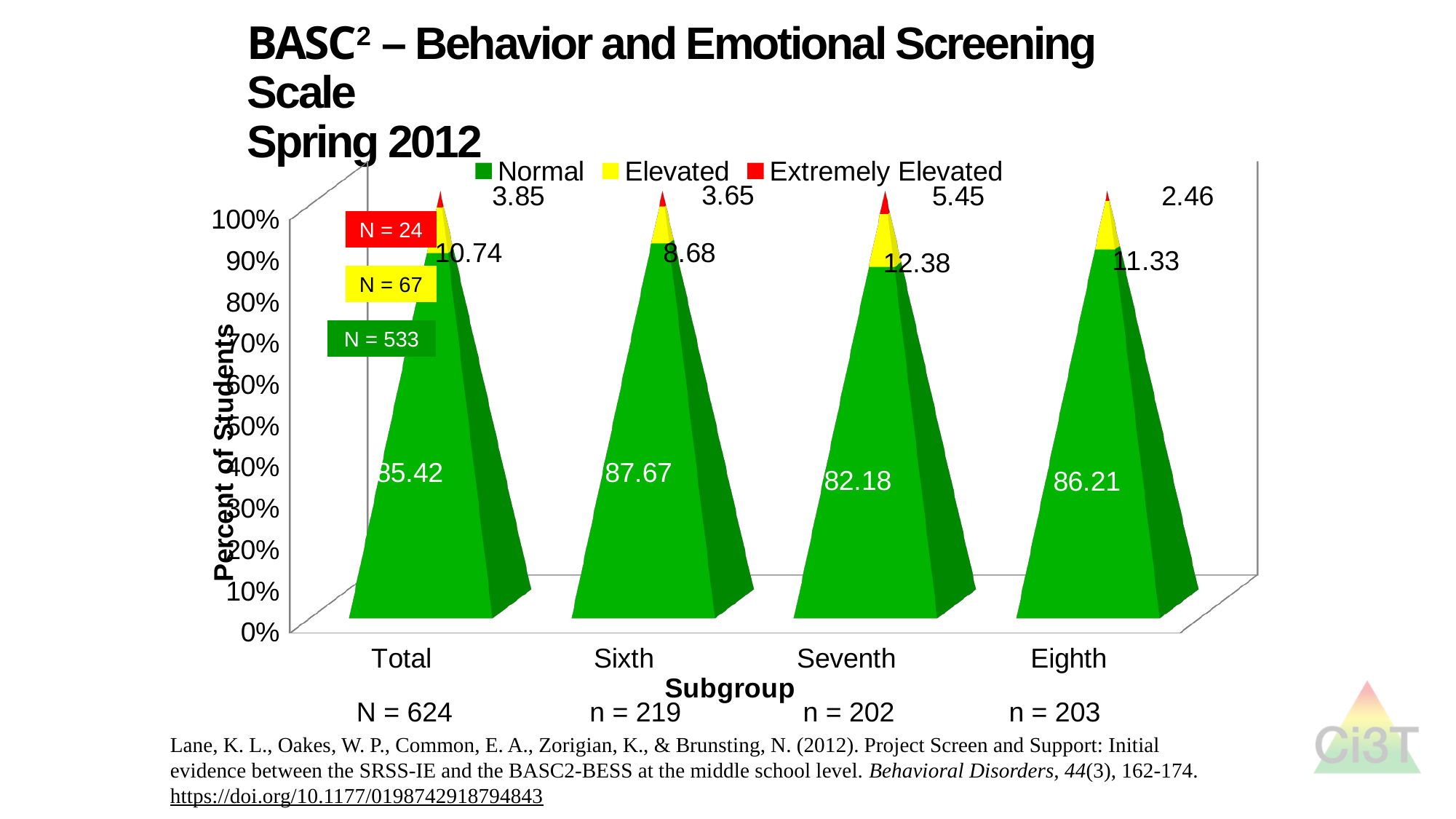
What is the Extremely Elevated value for the Eighth subgroup? 2.46 How many series does the legend list? 3 Which subgroup has the highest Normal value? Sixth What kind of chart is shown? Stacked bar chart Which subgroup has the highest Extremely Elevated value? Seventh What is the difference between the Normal values for Sixth and Seventh? 5.49 What is the Elevated value for the Seventh subgroup? 12.38 Which subgroup has the lowest Normal value? Seventh What is the Normal value for the Sixth subgroup? 87.67 How many subgroups are shown on the x axis? 4 Which is larger, the Elevated value for Sixth or for Eighth? Eighth What is the Normal value for the Total subgroup? 85.42